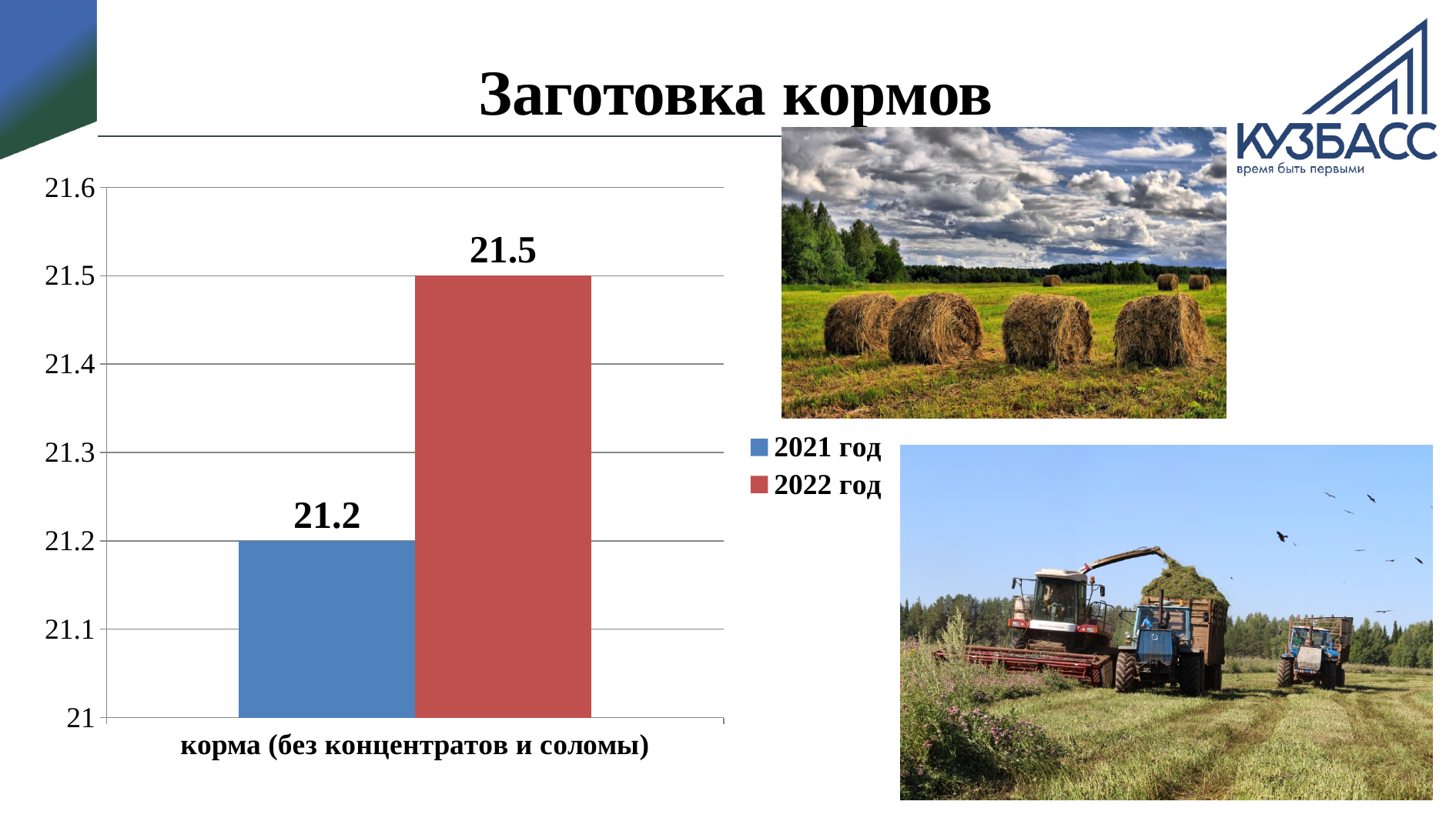
What is the value for 2022 год in the chart? 21.5 What kind of chart is shown on the slide? bar chart Is the value for 2021 год greater or less than 21.3? less Which series has the higher value, 2021 год or 2022 год? 2022 год What is the category label on the x axis? корма (без концентратов и соломы) How many categories are shown on the x axis? 1 What is the value for 2021 год in the chart? 21.2 Which series has the lowest value in the chart? 2021 год How many series does the legend list? 2 Is the value for 2022 год greater or less than 21.4? greater What is the difference between the 2022 год and 2021 год values? 0.3 What colour is the bar for 2022 год? red